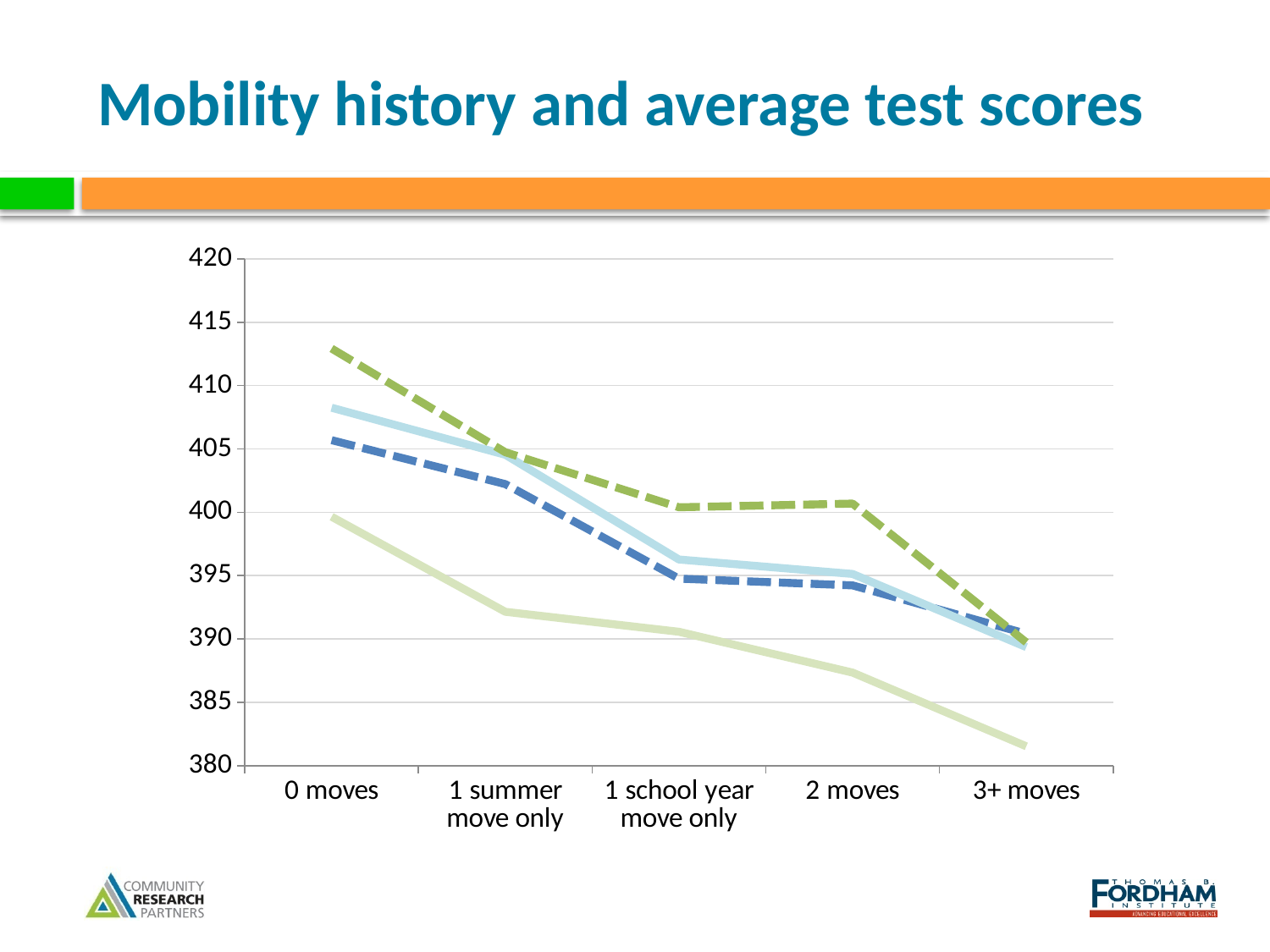
How many lines are plotted on the chart? 4 At 3+ moves, is the value of the light green solid line greater or less than 385? less What kind of chart is shown on the slide? line chart Which mobility category has the lowest test scores for all lines? 3+ moves At 2 moves, is the value of the light green solid line greater or less than 390? less Which mobility category has the highest test scores for all lines? 0 moves How many mobility categories are shown on the x axis? 5 What is the highest value shown on the y axis? 420 At 0 moves, is the value of the dark green dashed line greater or less than 410? greater At 0 moves, which line is higher: the dark green dashed line or the light green solid line? dark green dashed line Do the test scores generally rise or fall as the number of moves increases along the x axis? fall What is the title of the slide? Mobility history and average test scores